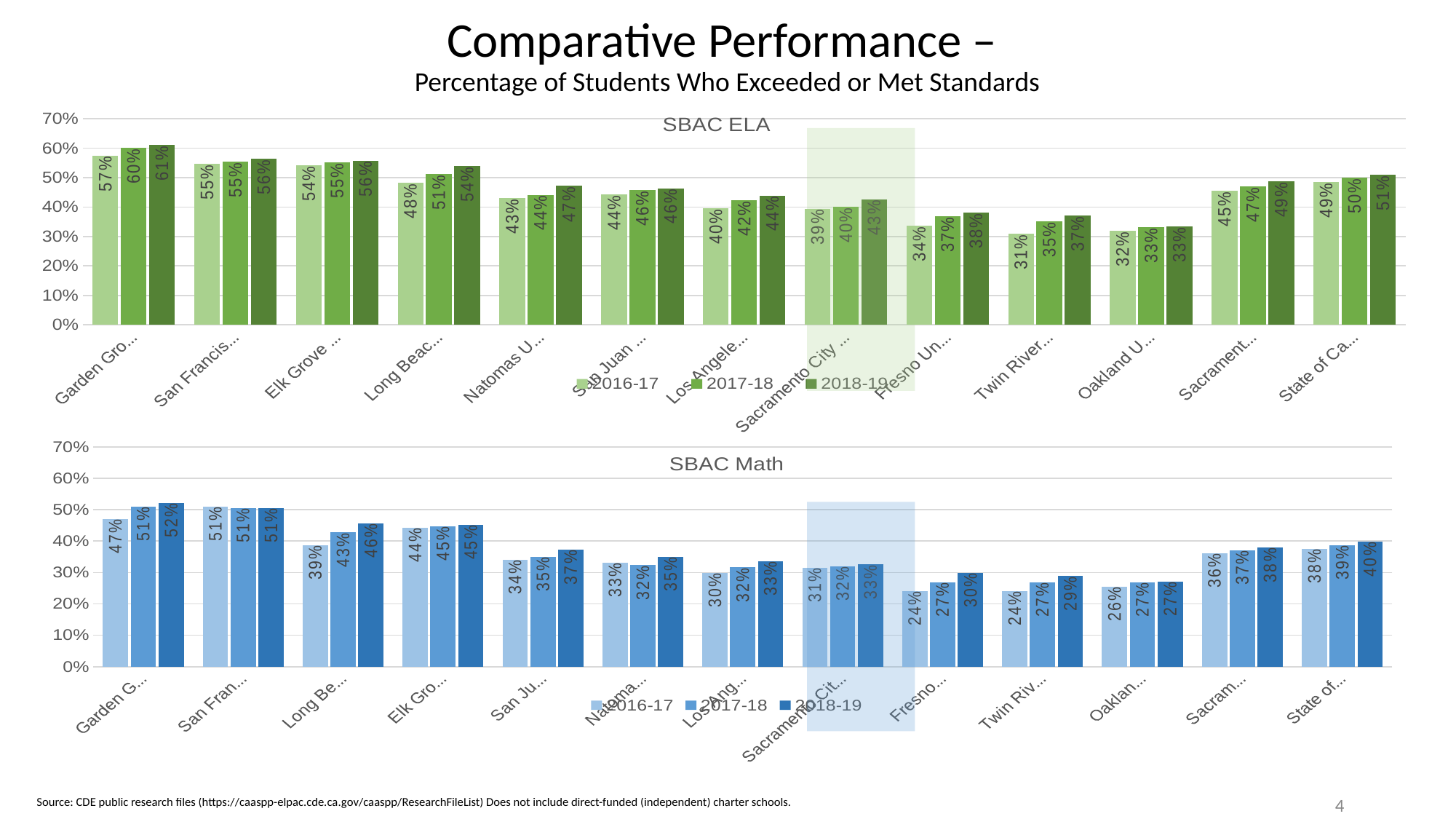
How many series does the legend of the SBAC ELA chart list? 3 In the SBAC ELA chart, what is the 2018-19 value for Garden Grove? 61% In the SBAC Math chart, what is the difference between the 2018-19 and 2016-17 values for Long Beach? 7% What type of chart is the SBAC Math chart? Bar chart In the SBAC ELA chart, is the 2017-18 value for Oakland greater or less than 40%? less How many districts/categories are shown in the SBAC Math chart? 13 In the SBAC Math chart, what is the 2016-17 value for Fresno? 24% In the SBAC Math chart, which is larger for 2018-19: Sacramento City or Los Angeles? They are equal (33%) In the SBAC ELA chart, which district has the lowest 2016-17 value? Twin Rivers In the SBAC ELA chart, do the values for Sacramento City rise or fall from 2016-17 to 2018-19? Rise In the SBAC ELA chart, which district has the highest 2018-19 value? Garden Grove What are the three series listed in the legend of the SBAC Math chart? 2016-17, 2017-18, 2018-19